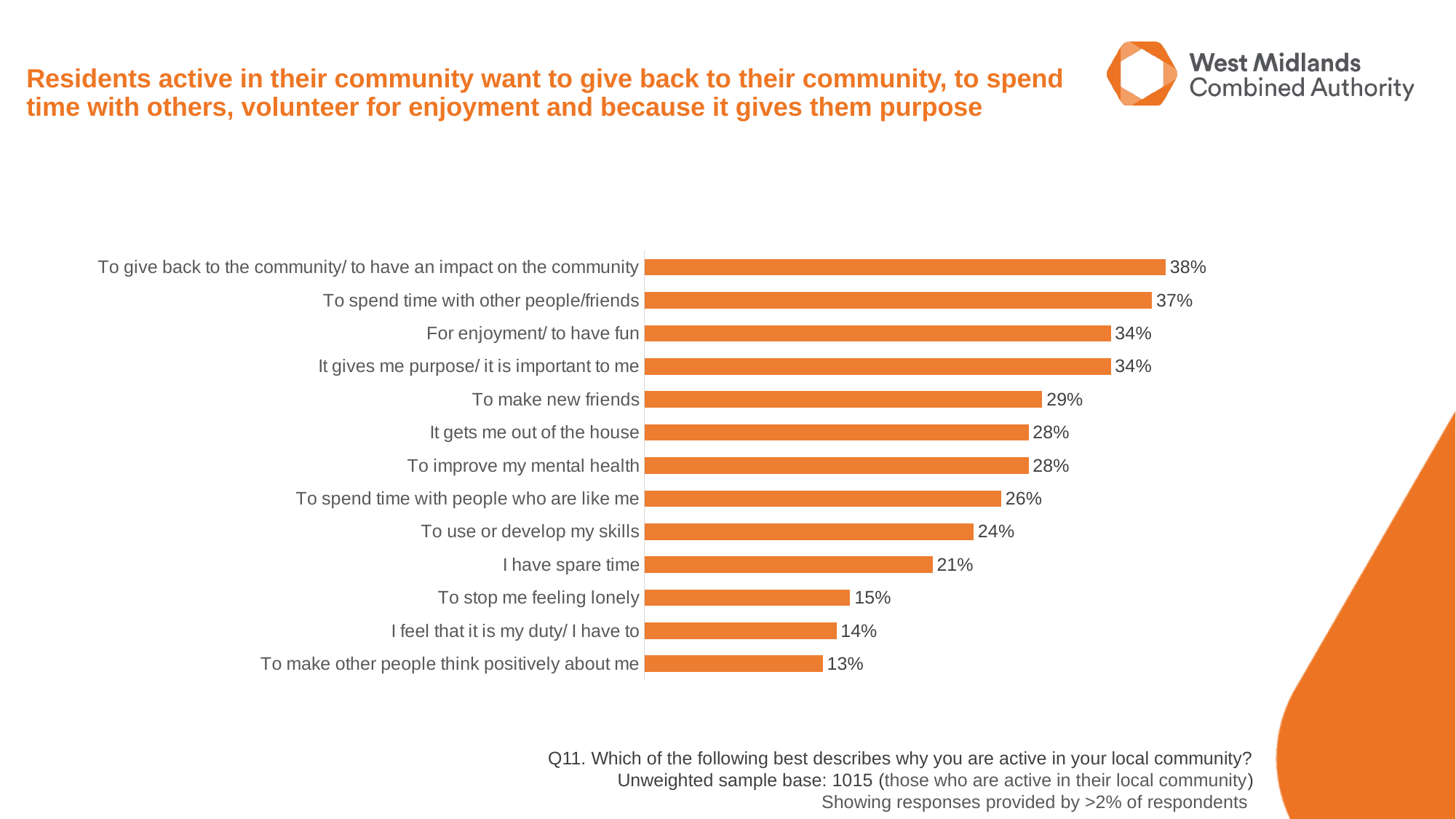
Which has a higher value: 'I feel that it is my duty/ I have to' or 'To stop me feeling lonely'? To stop me feeling lonely Which reason has the highest percentage of respondents? To give back to the community/ to have an impact on the community What kind of chart is shown on the slide? Bar chart What percentage of respondents said they are active in their community to give back to the community/ to have an impact on the community? 38% What is the difference in percentage points between 'To make new friends' and 'To use or develop my skills'? 5 How many reasons (categories) are shown in the chart? 13 Which has a higher value: 'It gets me out of the house' or 'To spend time with people who are like me'? It gets me out of the house Which reason has the lowest percentage of respondents? To make other people think positively about me What is the difference in percentage points between 'To spend time with other people/friends' and 'To stop me feeling lonely'? 22 What is the value for 'To improve my mental health'? 28% What percentage of respondents chose 'I have spare time'? 21% What is the unweighted sample base stated below the chart? 1015